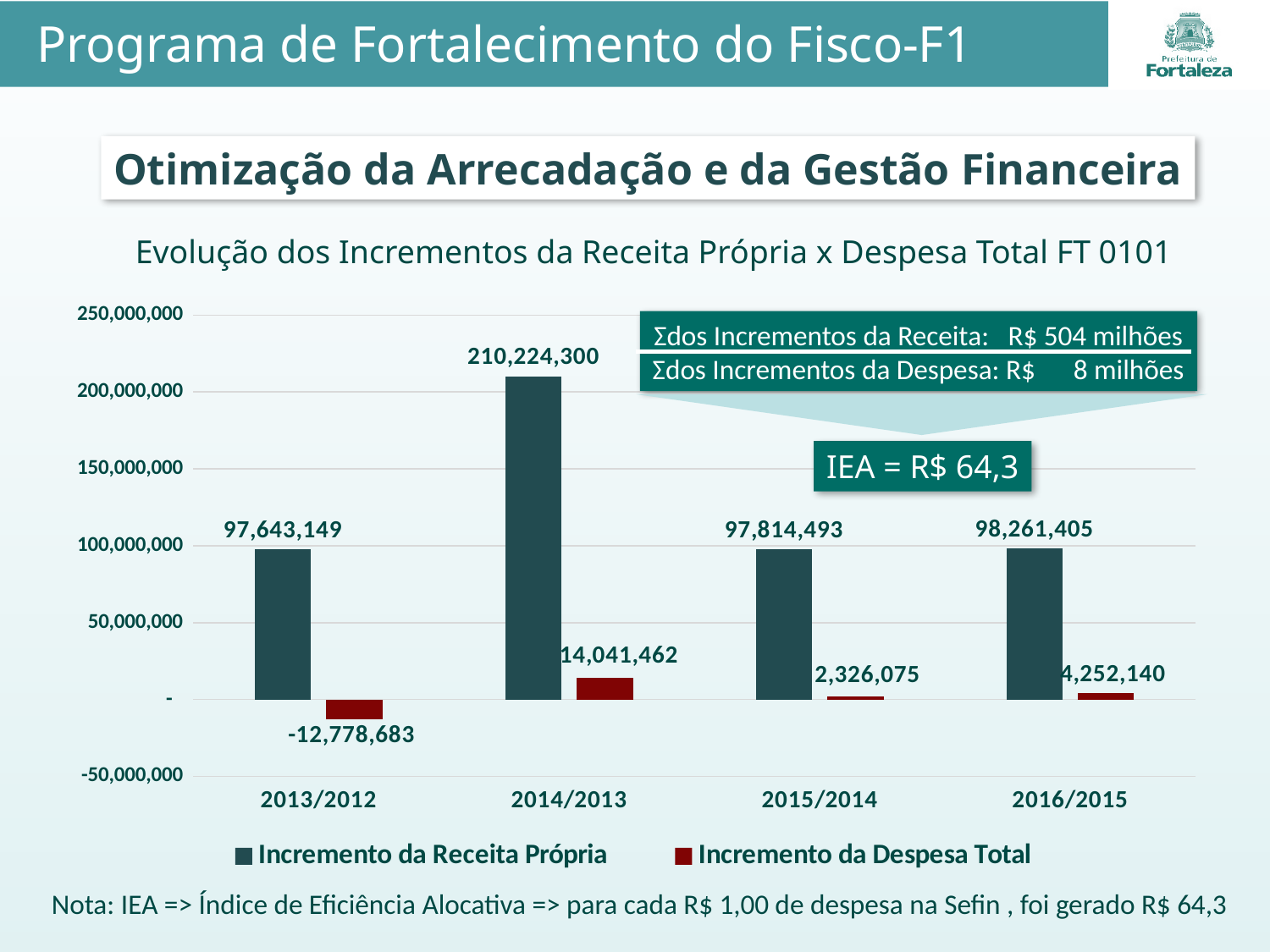
How many periods are shown on the x axis of the chart? 4 Which period has the highest Incremento da Receita Própria? 2014/2013 What is the value of Incremento da Receita Própria for 2014/2013? 210,224,300 Which is larger: Incremento da Despesa Total in 2015/2014 or in 2016/2015? 2016/2015 What kind of chart is shown on the slide? Bar chart What is the difference between Incremento da Despesa Total in 2014/2013 and in 2016/2015? 9,789,322 How many series does the chart legend list? 2 What is the value of Incremento da Despesa Total for 2016/2015? 4,252,140 Is the Incremento da Receita Própria for 2014/2013 greater or less than 200,000,000? greater What is the difference between Incremento da Receita Própria in 2014/2013 and in 2013/2012? 112,581,151 Which period has the lowest Incremento da Despesa Total? 2013/2012 What is the value of Incremento da Despesa Total for 2013/2012? -12,778,683